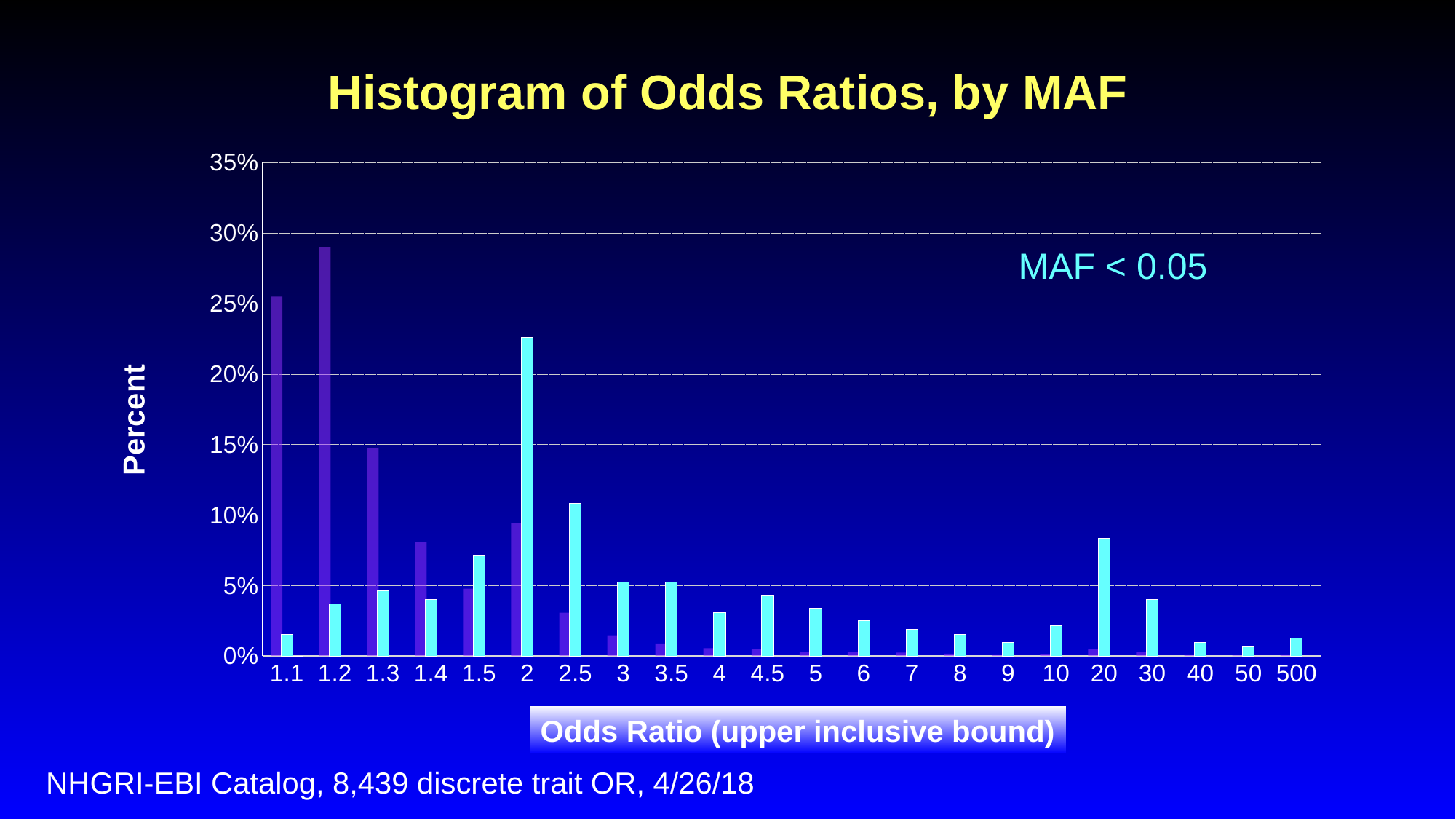
Which odds ratio category has the tallest purple bar? 1.2 Is the purple bar for odds ratio 1.3 greater or less than 10%? greater What label is printed in cyan text in the upper right of the plot area? MAF < 0.05 Is the purple bar for odds ratio 1.2 greater or less than 25%? greater Is the cyan bar for odds ratio 20 greater or less than 10%? less What is the title of the chart? Histogram of Odds Ratios, by MAF Which is larger, the purple bar or the cyan bar for odds ratio 1.1? purple bar Which odds ratio category has the tallest cyan (MAF < 0.05) bar? 2 How many odds ratio categories are shown on the x axis? 22 What kind of chart is shown on the slide? bar chart Which is larger, the cyan bar for odds ratio 2.5 or the cyan bar for odds ratio 3? 2.5